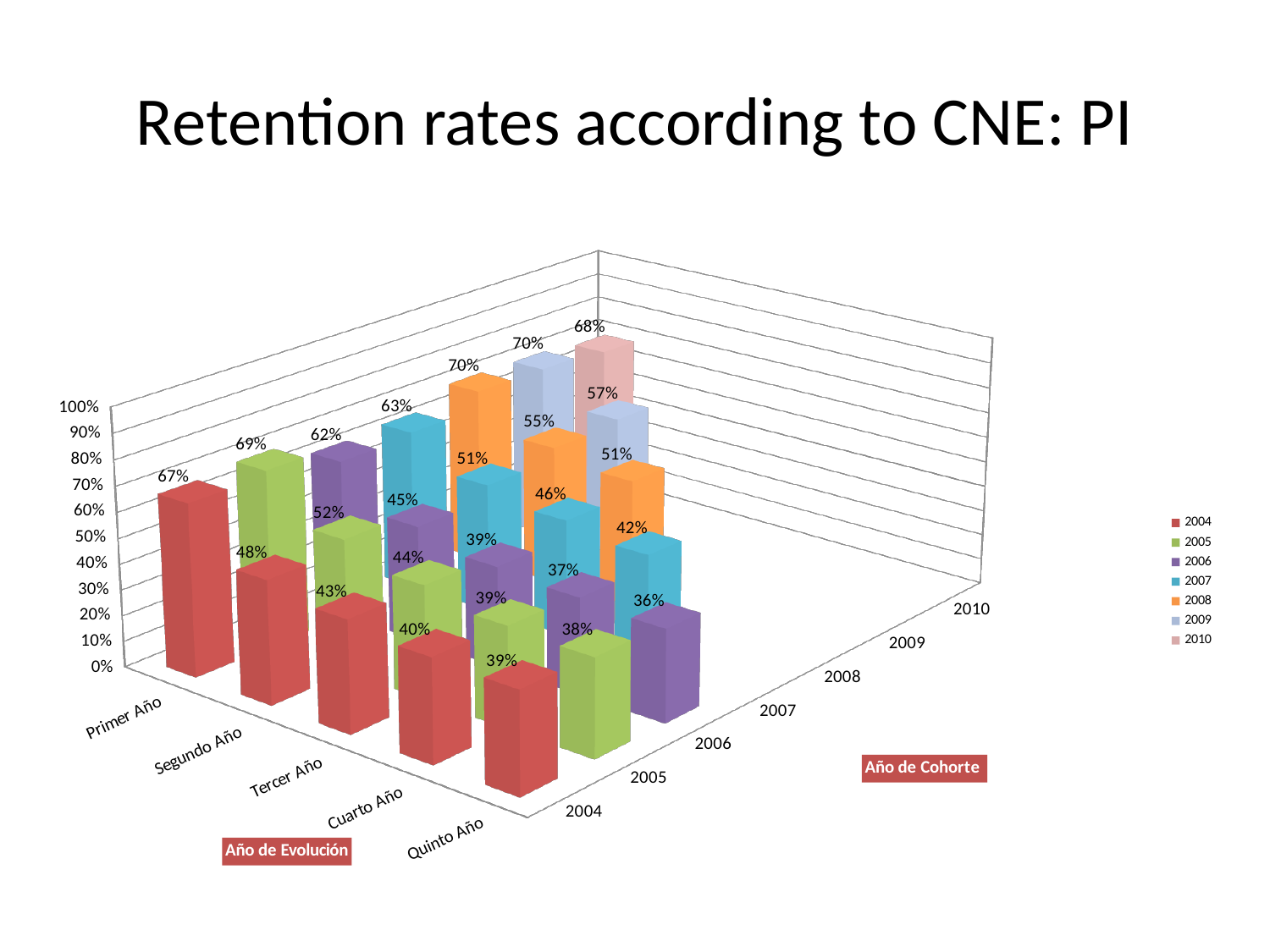
What is the retention rate for the 2007 cohort in Cuarto Año? 42% What kind of chart is shown on the slide? Bar chart What is the retention rate for the 2010 cohort in Primer Año? 68% What is the retention rate for the 2006 cohort in Quinto Año? 36% How many series does the legend list? 7 Which is larger for Segundo Año: the 2005 cohort or the 2009 cohort? 2009 For the 2004 cohort, do the retention rates rise or fall from Primer Año to Quinto Año? Fall What is the difference between the 2004 cohort's Primer Año rate (67%) and its Quinto Año rate (39%)? 28% What is the retention rate for the 2004 cohort in Primer Año? 67% What is the retention rate for the 2008 cohort in Segundo Año? 55% How many categories are shown on the Año de Evolución axis? 5 What is the title of the slide? Retention rates according to CNE: PI